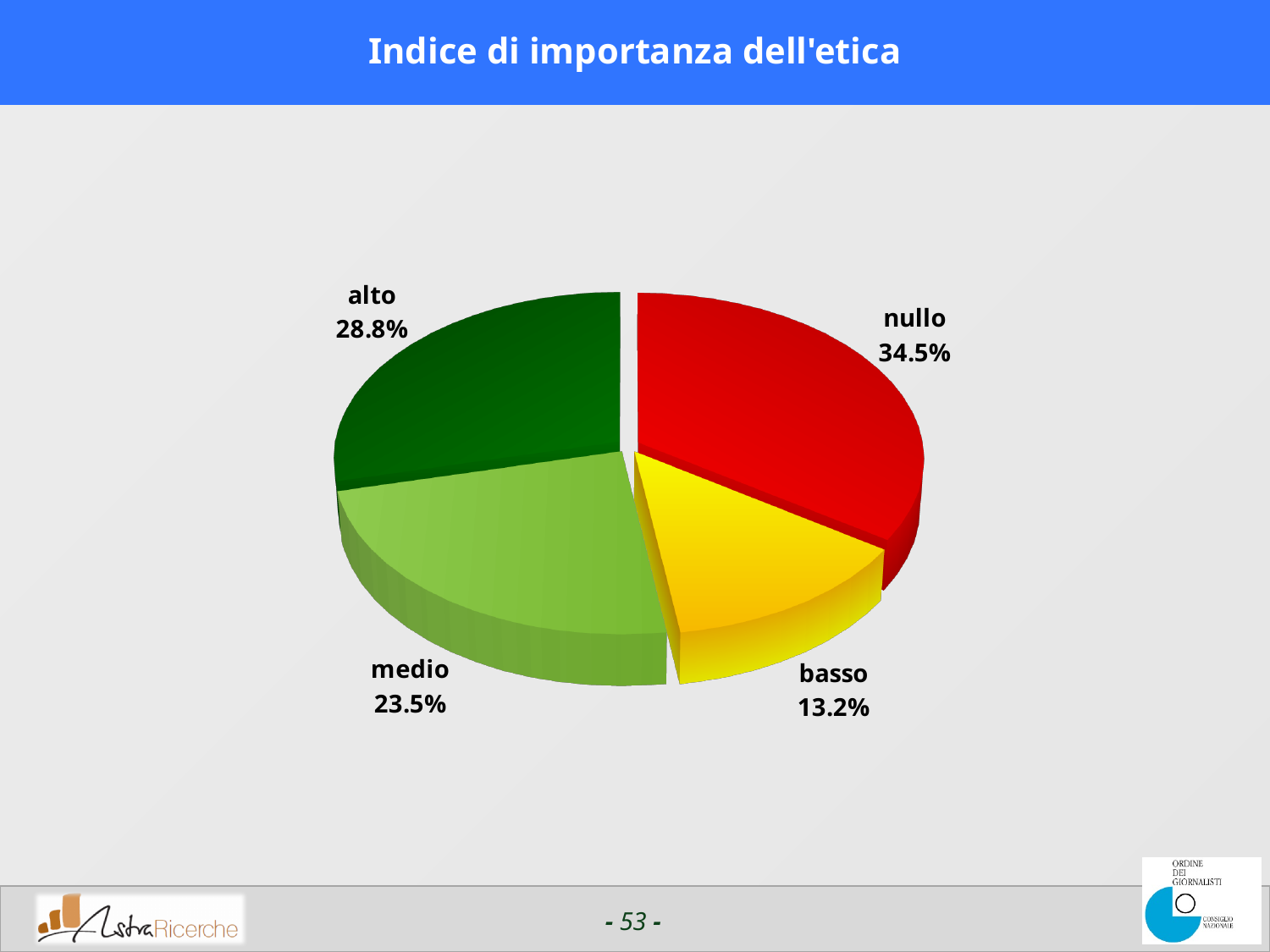
What is the title of the chart? Indice di importanza dell'etica Which is larger, the 'alto' slice or the 'medio' slice? alto What is the difference between the 'nullo' and 'basso' values? 21.3% What is the value for the 'basso' slice? 13.2% What is the difference between the 'alto' and 'medio' values? 5.3% Which category has the largest share of the pie? nullo What is the value for the 'alto' slice? 28.8% Which category has the smallest share of the pie? basso What is the value for the 'medio' slice? 23.5% What kind of chart is shown on the slide? pie chart How many slices does the pie chart have? 4 What is the value for the 'nullo' slice? 34.5%